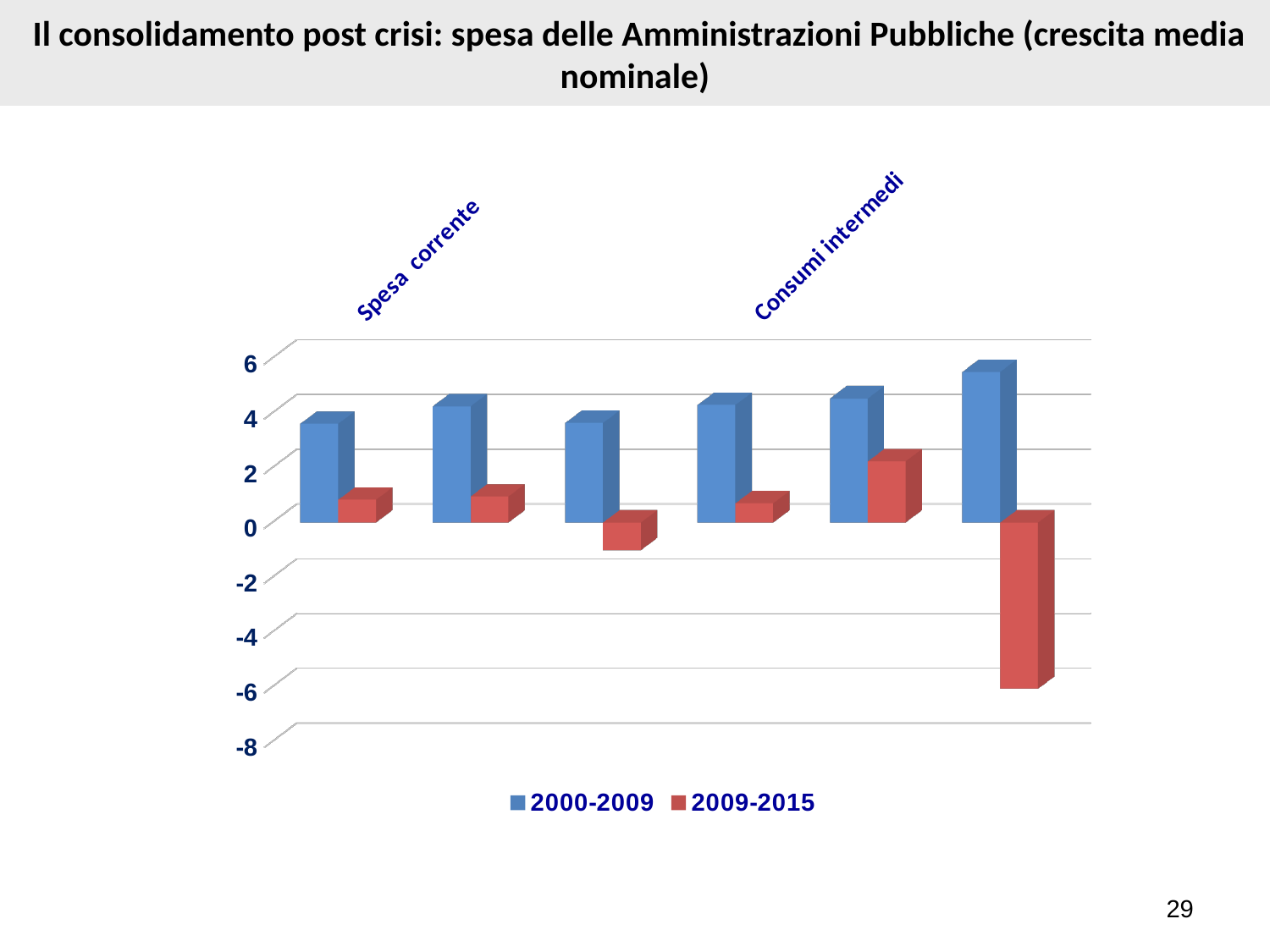
In which group of bars does the 2009-2015 series reach its lowest value? the rightmost group Which colour represents the 2009-2015 series? red Is the 2009-2015 value for the rightmost group of bars greater or less than -4? less Is the 2000-2009 value for the rightmost group of bars greater or less than 4? greater In the rightmost group of bars, which series has the larger value, 2000-2009 or 2009-2015? 2000-2009 Is the 2000-2009 value for the leftmost group of bars greater or less than 2? greater How many series does the legend list? 2 In which group of bars does the 2000-2009 series reach its highest value? the rightmost group How many groups of bars are plotted in the chart? 6 What kind of chart is shown on the slide? bar chart What are the two series named in the legend? 2000-2009 and 2009-2015